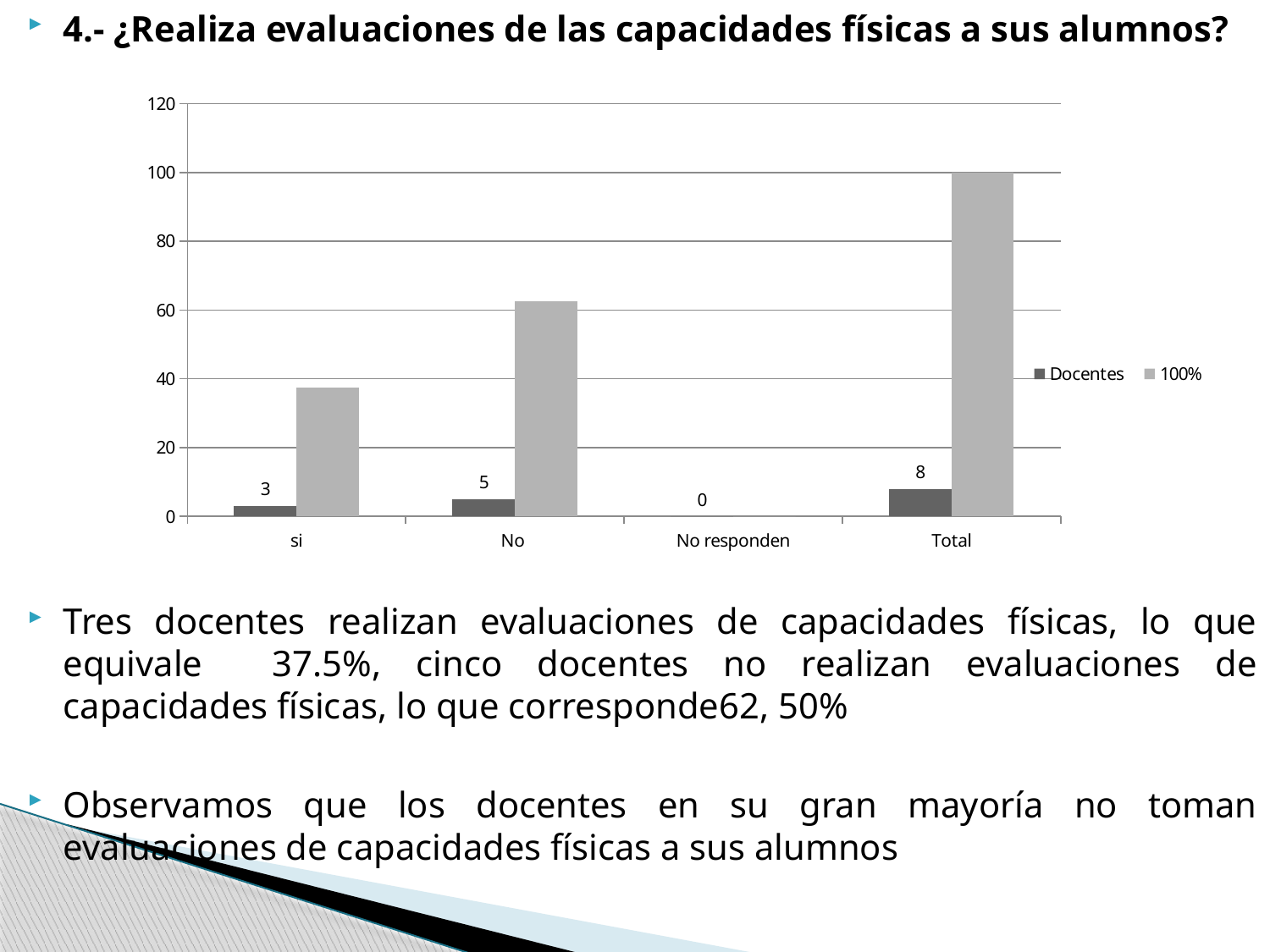
How many series does the legend list? 2 What is the Docentes value for 'No responden'? 0 What is the difference between the Docentes values for 'No' and 'si'? 2 Which category has the lowest Docentes value? No responden What kind of chart is shown on the slide? bar chart Excluding Total, which category has the highest Docentes value? No What are the two series named in the legend? Docentes and 100% What is the Docentes value for 'Total'? 8 What is the Docentes value for the category 'No'? 5 How many categories are shown on the x axis? 4 Is the 100% series value for 'No' greater or less than 60? greater What is the Docentes value for the category 'si'? 3